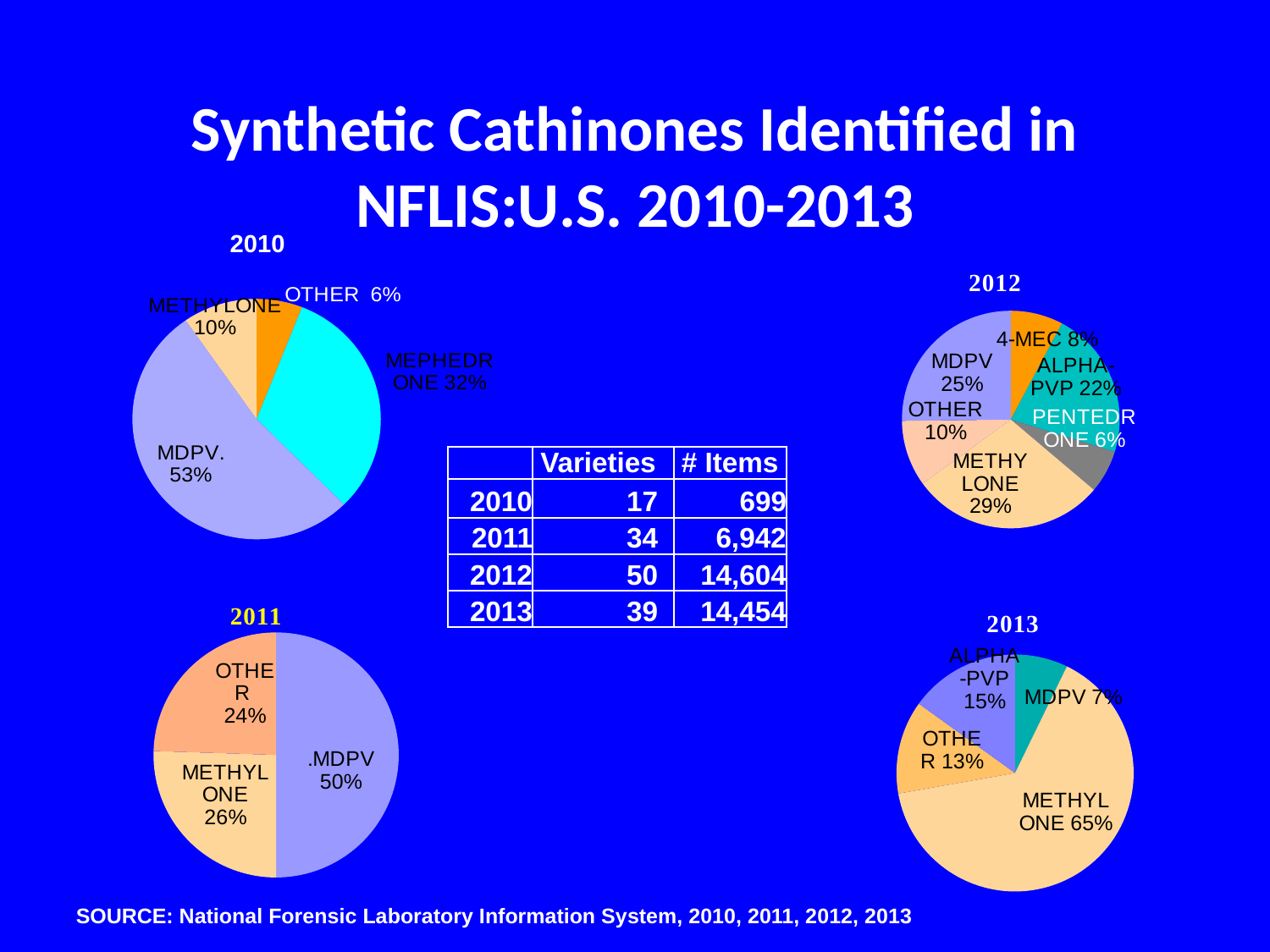
In the 2011 pie chart, what share does METHYLONE have? 26% In the 2010 pie chart, how many slices are there? 4 In the 2010 pie chart, what share does MEPHEDRONE have? 32% In the 2012 pie chart, which category has the smallest slice? PENTEDRONE In the 2010 pie chart, what share does MDPV have? 53% In the 2010 pie chart, which category has the largest slice? MDPV In the 2011 pie chart, what is the difference between the MDPV share and the OTHER share? 26% In the 2013 pie chart, which is larger, the ALPHA-PVP slice or the MDPV slice? ALPHA-PVP What kind of chart is used for the 2013 data? Pie chart In the 2012 pie chart, how many slices are there? 6